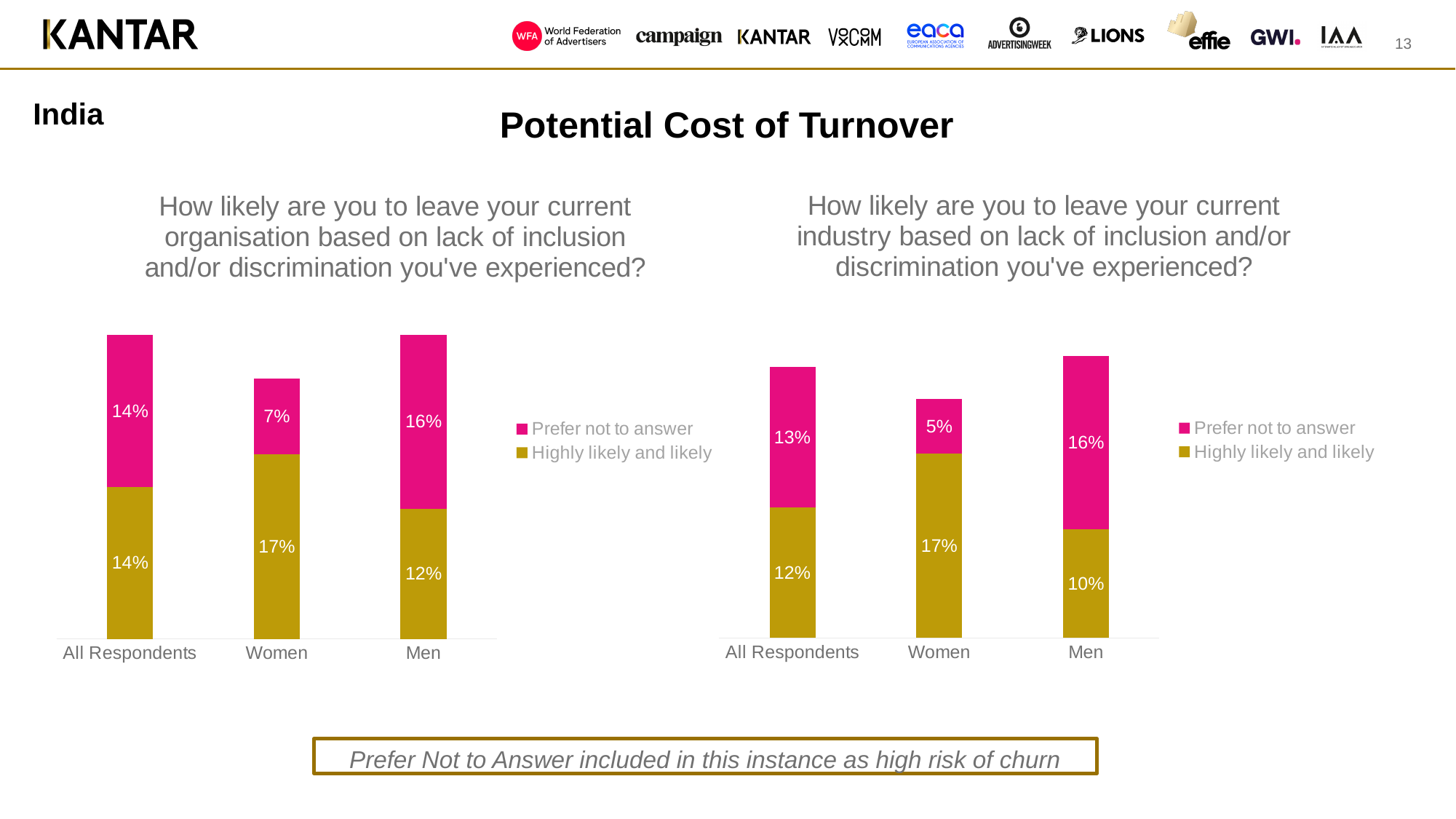
In the left chart (leave your current organisation), which category has the lowest 'Prefer not to answer' value? Women In the right chart (leave your current industry), what is the 'Prefer not to answer' value for Women? 5% In the right chart (leave your current industry), what is the difference between the 'Highly likely and likely' values for Women and Men? 7% What type of chart is the left chart (leave your current organisation)? Stacked bar chart In the left chart (leave your current organisation), what is the 'Prefer not to answer' value for Men? 16% In the right chart (leave your current industry), which category has the highest 'Highly likely and likely' value? Women In the right chart (leave your current industry), what is the total of the stacked bar for Men? 26% In the left chart (leave your current organisation), what is the total of the stacked bar for Women? 24% In the left chart (leave your current organisation), is the 'Highly likely and likely' value larger for Women or for Men? Women In the right chart (leave your current industry), what is the 'Highly likely and likely' value for All Respondents? 12% In the left chart (leave your current organisation), what is the 'Highly likely and likely' value for Women? 17% How many series does the legend of the right chart (leave your current industry) list? 2